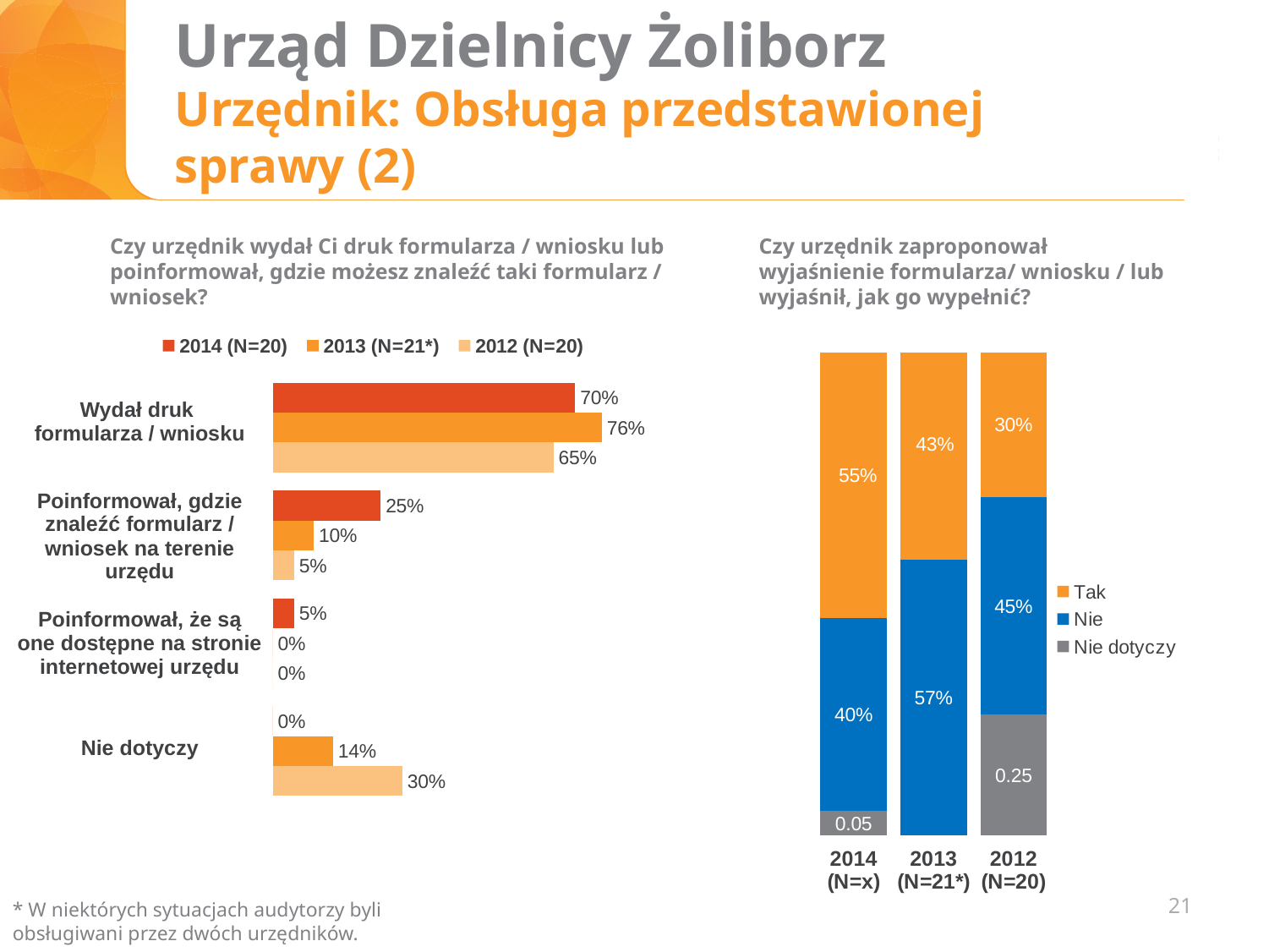
What kind of chart is the left chart? Bar chart In the left chart, what is the difference between the 2014 and 2012 values for "Wydał druk formularza / wniosku"? 5% In the left chart, what is the 2012 (N=20) value for "Nie dotyczy"? 30% In the right stacked chart, what is the "Nie" value for 2013 (N=21*)? 57% In the left chart, how many categories are shown? 4 In the left chart, how many series does the legend list? 3 In the right stacked chart, which year has the lowest "Tak" value? 2012 (N=20) In the left chart, which year has the highest value for "Wydał druk formularza / wniosku"? 2013 (N=21*) In the right stacked chart, is the "Nie" value for 2014 (N=x) larger or smaller than the "Nie" value for 2013 (N=21*)? Smaller In the left chart, what is the 2014 (N=20) value for "Poinformował, gdzie znaleźć formularz / wniosek na terenie urzędu"? 25% In the left chart, what is the 2013 (N=21*) value for "Wydał druk formularza / wniosku"? 76% In the right stacked chart, what is the "Tak" value for 2012 (N=20)? 30%